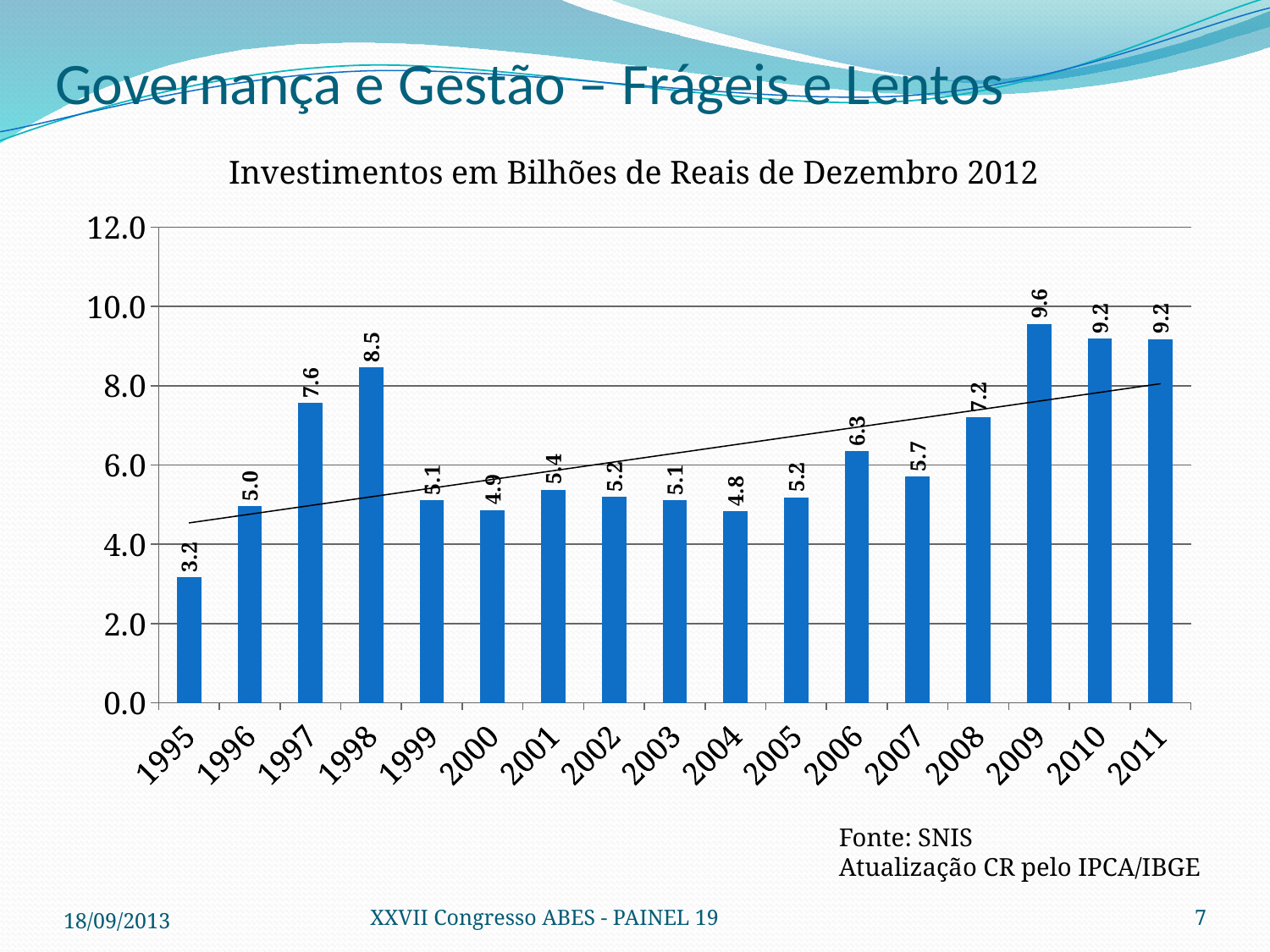
What is the value for 2008? 7.2 What is the title of the chart? Investimentos em Bilhões de Reais de Dezembro 2012 How many years are shown on the x axis? 17 Is the value for 2010 greater or less than 8.0? greater Which year has the lowest value? 1995 Which year has the highest value? 2009 What is the value for 2004? 4.8 What is the value for 1998? 8.5 Do the values rise or fall from 2007 to 2009? rise Which is larger, the value for 1997 or the value for 2006? 1997 What kind of chart is this? bar chart What is the difference between the values for 2009 and 1995? 6.4